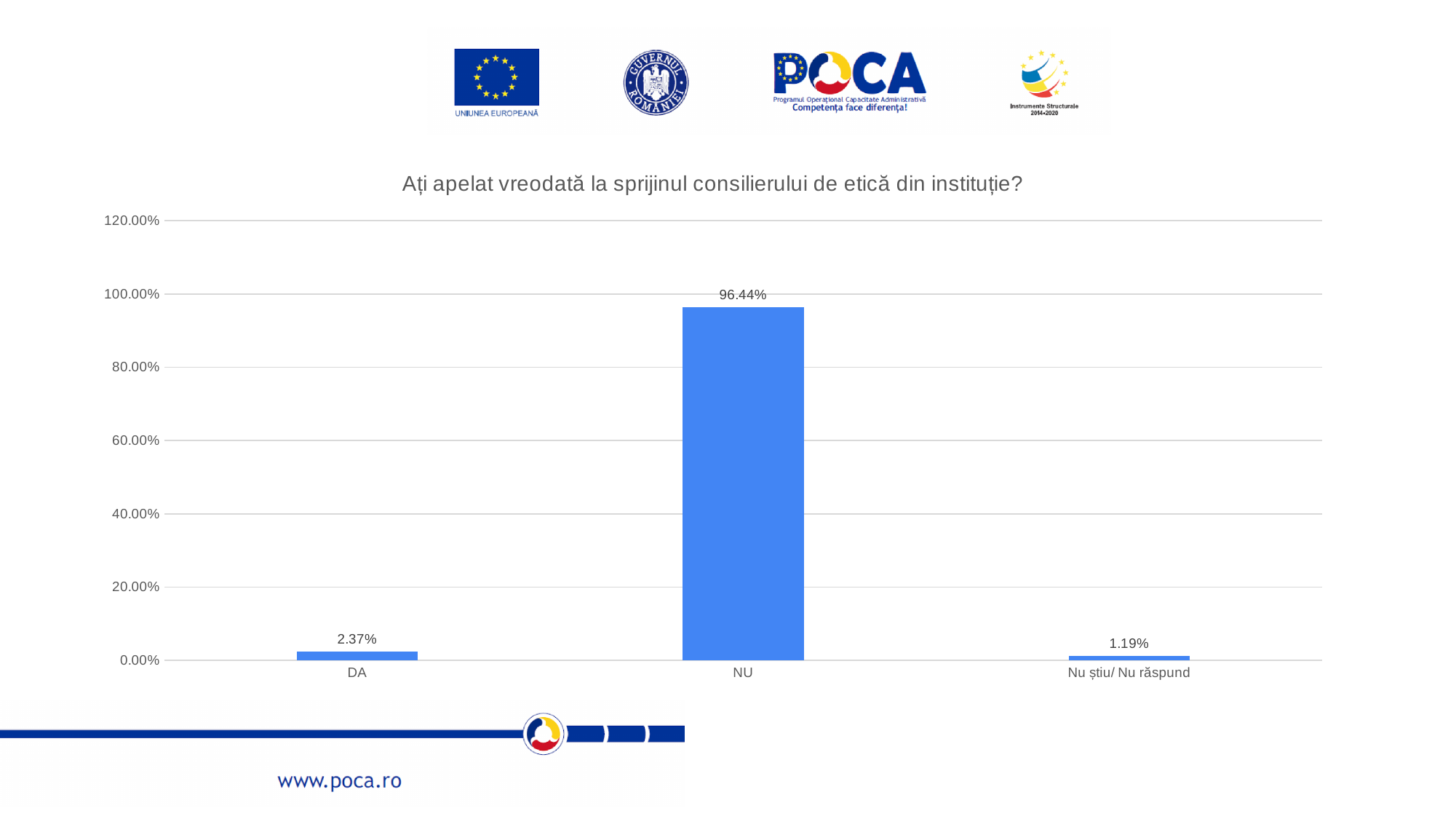
What is the difference between the values for DA and Nu știu/ Nu răspund? 1.18% What is the value for NU? 96.44% Which is larger, the value for DA or the value for Nu știu/ Nu răspund? DA What kind of chart is shown on the slide? bar chart Is the value for NU greater or less than 80.00%? greater What is the value for DA? 2.37% Which category has the lowest value? Nu știu/ Nu răspund What is the title of the chart? Ați apelat vreodată la sprijinul consilierului de etică din instituție? How many categories are shown on the x axis? 3 What is the value for Nu știu/ Nu răspund? 1.19% Which category has the highest value? NU What is the difference between the values for NU and DA? 94.07%